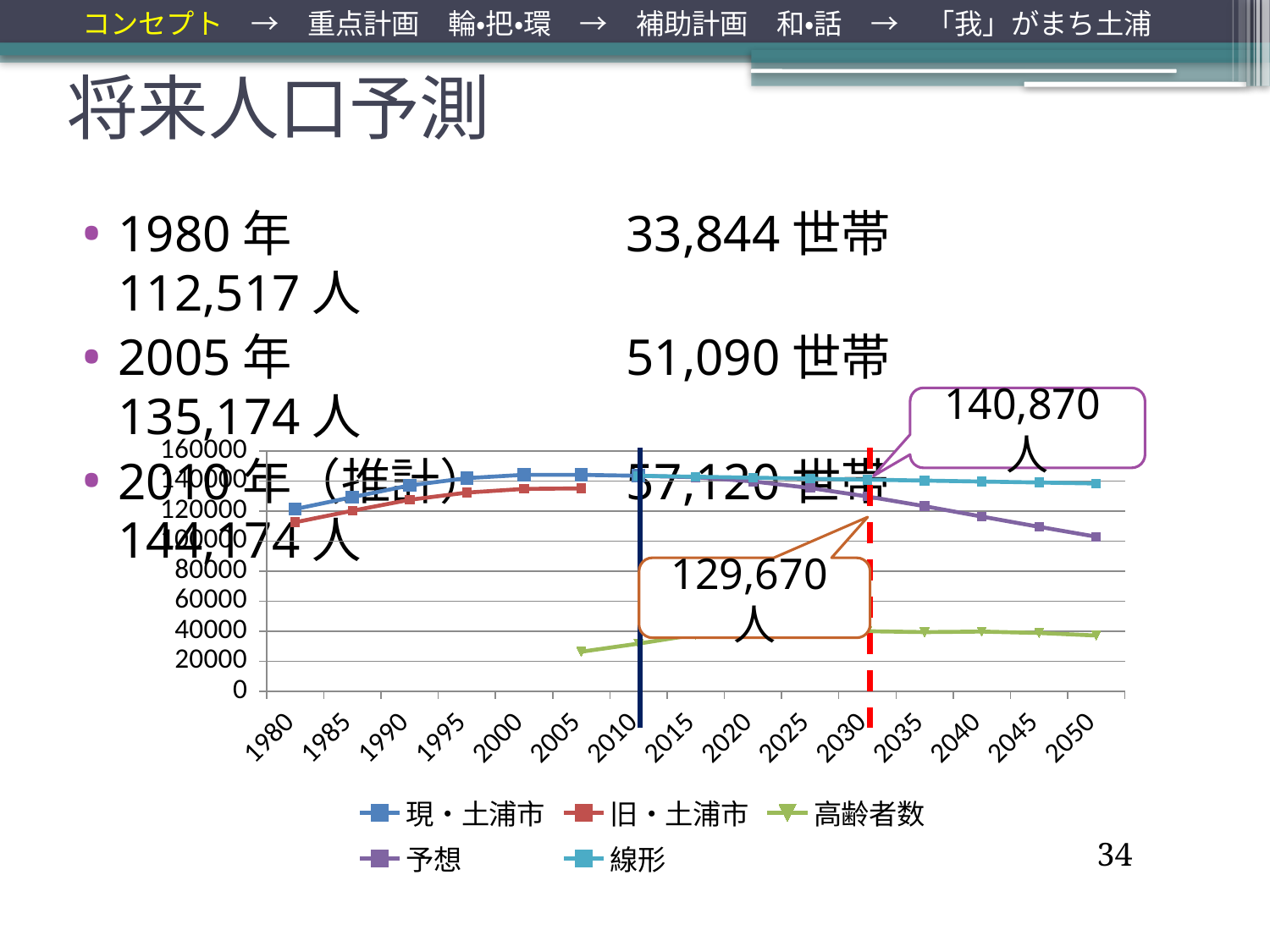
How many series does the chart legend list? 5 Is the value of 現・土浦市 in 1980 greater or less than 100000? greater What kind of chart is shown on the slide? line chart Which series in the chart has the lowest values throughout? 高齢者数 What value is shown in the upper callout box on the chart? 140,870 人 Is the value of 高齢者数 in 2005 greater or less than 40000? less How many year labels are shown on the x axis of the chart? 15 Does the 予想 series rise or fall from 2030 to 2050? fall Is the value of 線形 in 2050 greater or less than 120000? greater In 2050, which series has the larger value, 線形 or 予想? 線形